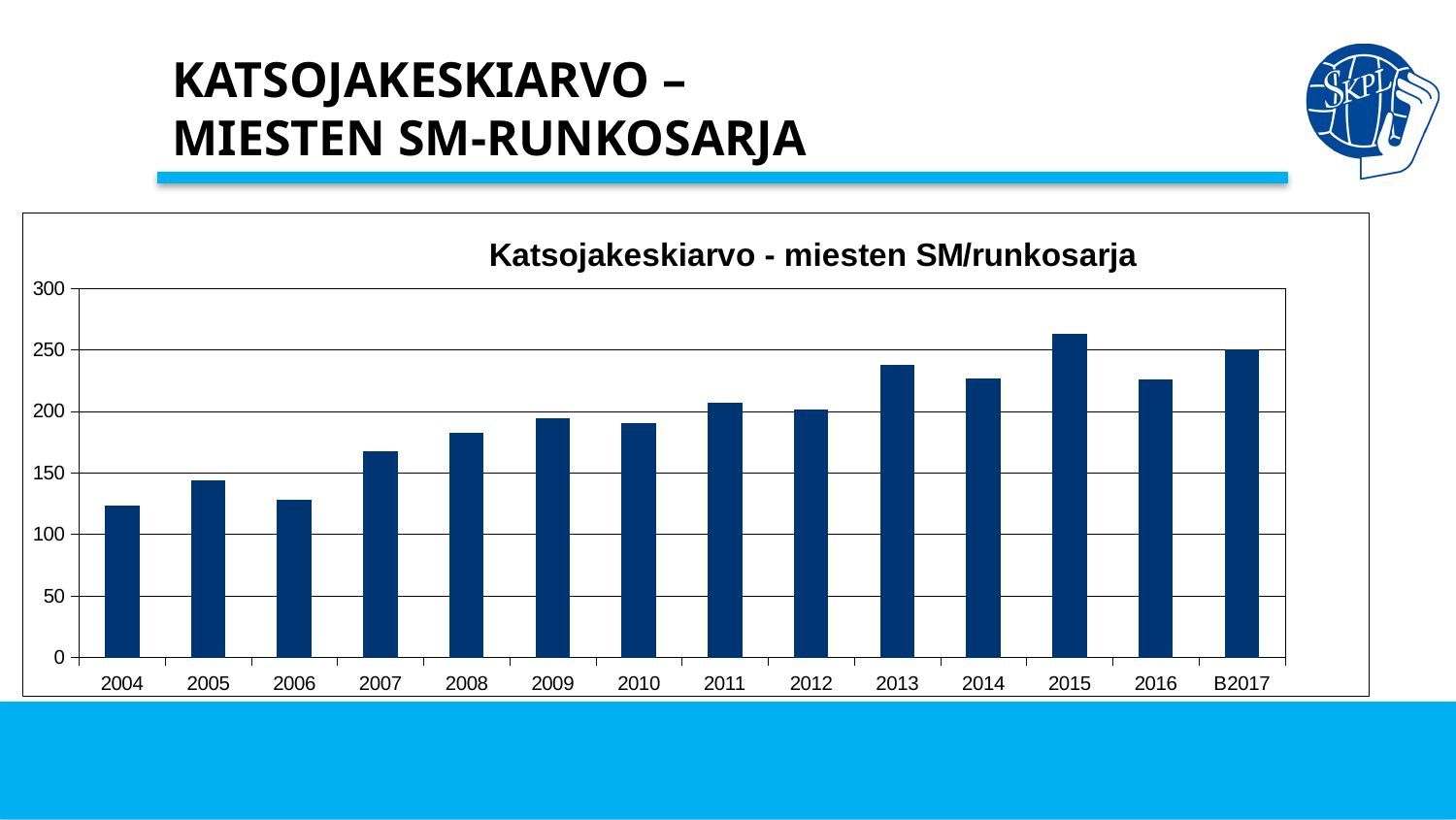
Which is larger, the value for 2005 or the value for 2006? 2005 Which is larger, the value for 2013 or the value for 2014? 2013 Do the values generally rise or fall from 2004 to B2017? rise Is the value for 2004 greater or less than 150? less Is the value for 2009 greater or less than 200? less How many categories (seasons) are shown on the x axis? 14 What is the title of the chart? Katsojakeskiarvo - miesten SM/runkosarja What kind of chart is shown on the slide? bar chart Which season has the highest value? 2015 Is the value for 2015 greater or less than 250? greater